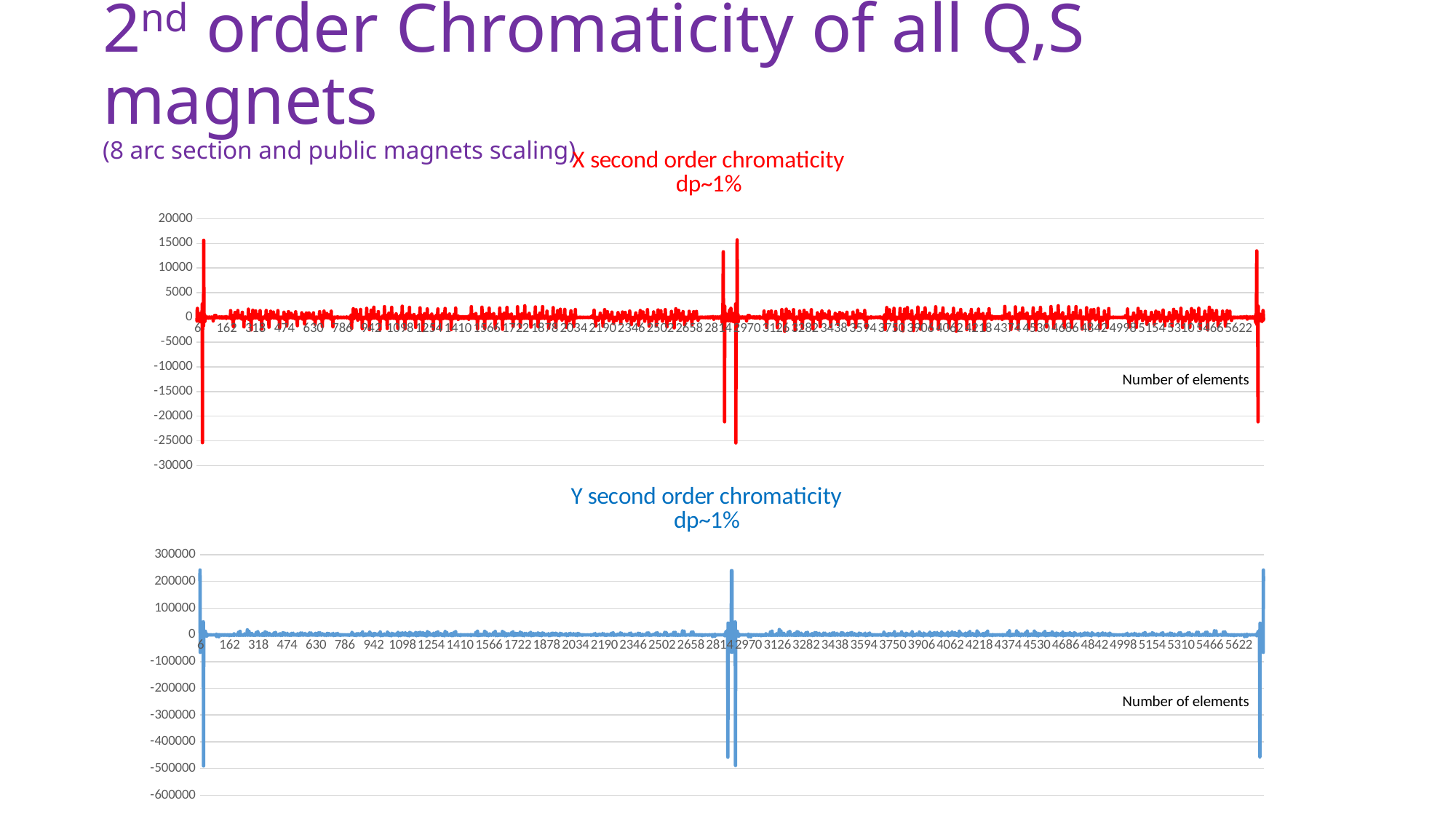
What kind of chart is the 'Y second order chromaticity' chart at the bottom of the slide? line chart What label is shown for the horizontal axis of the bottom 'Y second order chromaticity' chart? Number of elements In the top 'X second order chromaticity' chart, is the lowest value plotted greater or less than -20000? less In the top 'X second order chromaticity' chart, is the lowest value plotted greater or less than -30000? greater What is the title of the top chart on the slide? X second order chromaticity dp~1% In the bottom 'Y second order chromaticity' chart, is the lowest value plotted greater or less than -400000? less Which chart reaches a higher maximum value, the 'X second order chromaticity' chart or the 'Y second order chromaticity' chart? Y second order chromaticity What kind of chart is the 'X second order chromaticity' chart at the top of the slide? line chart Which chart reaches a lower minimum value, the 'X second order chromaticity' chart or the 'Y second order chromaticity' chart? Y second order chromaticity